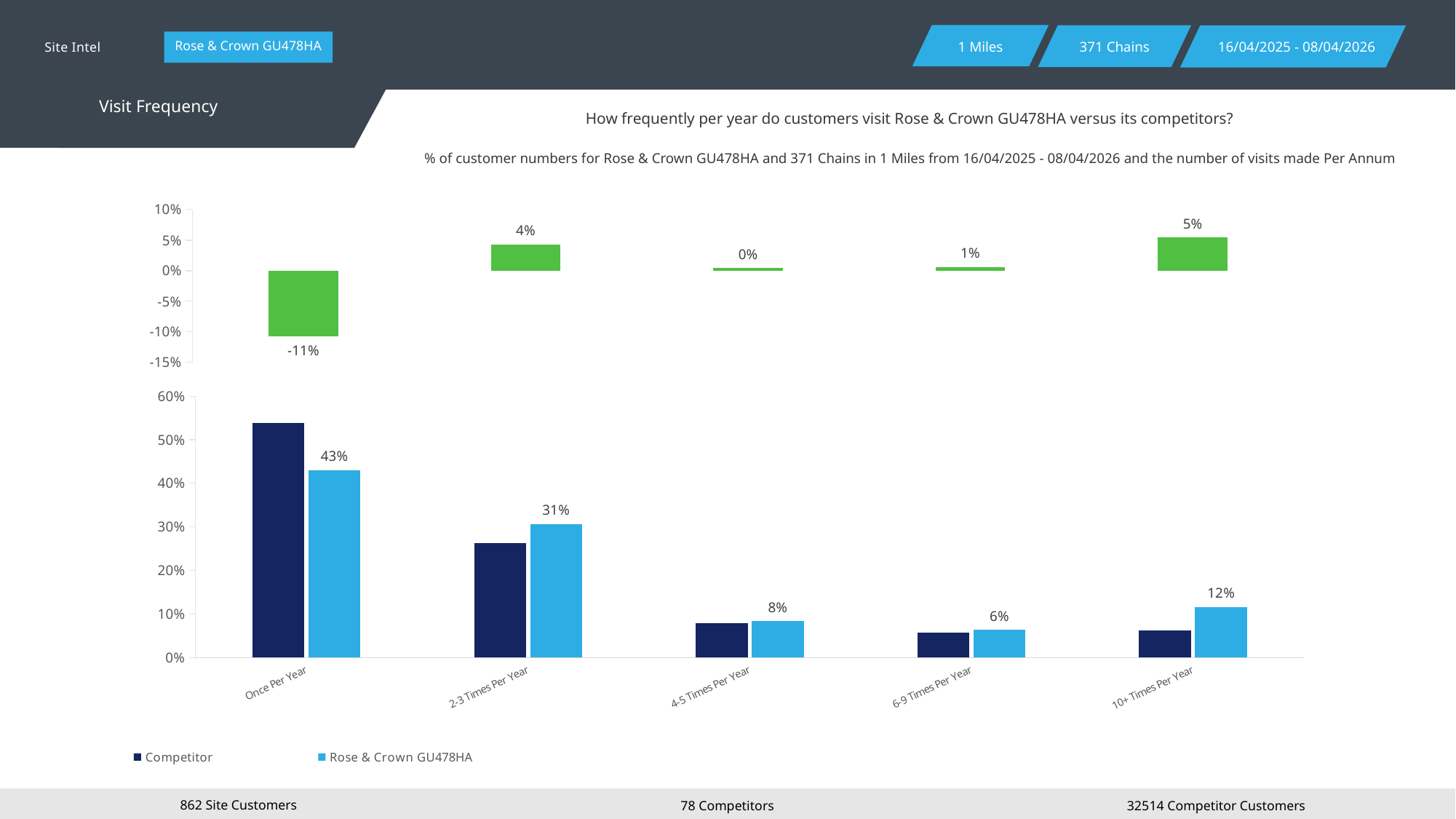
In the bottom chart, for Once Per Year, which is larger: Competitor or Rose & Crown GU478HA? Competitor In the top chart, what is the value for Once Per Year? -11% How many series does the legend of the bottom chart list? 2 In the bottom chart, what is the value for Rose & Crown GU478HA for 10+ Times Per Year? 12% What kind of chart is the bottom chart? bar chart In the bottom chart, which category has the lowest value for Rose & Crown GU478HA? 6-9 Times Per Year How many categories are shown on the x axis of the bottom chart? 5 In the bottom chart, what is the difference between the Rose & Crown GU478HA values for Once Per Year and 2-3 Times Per Year? 12% In the bottom chart, is the Competitor value for Once Per Year greater or less than 50%? greater In the top chart, which category has the lowest value? Once Per Year In the bottom chart, what is the value for Rose & Crown GU478HA for Once Per Year? 43% In the top chart, which category has the highest value? 10+ Times Per Year